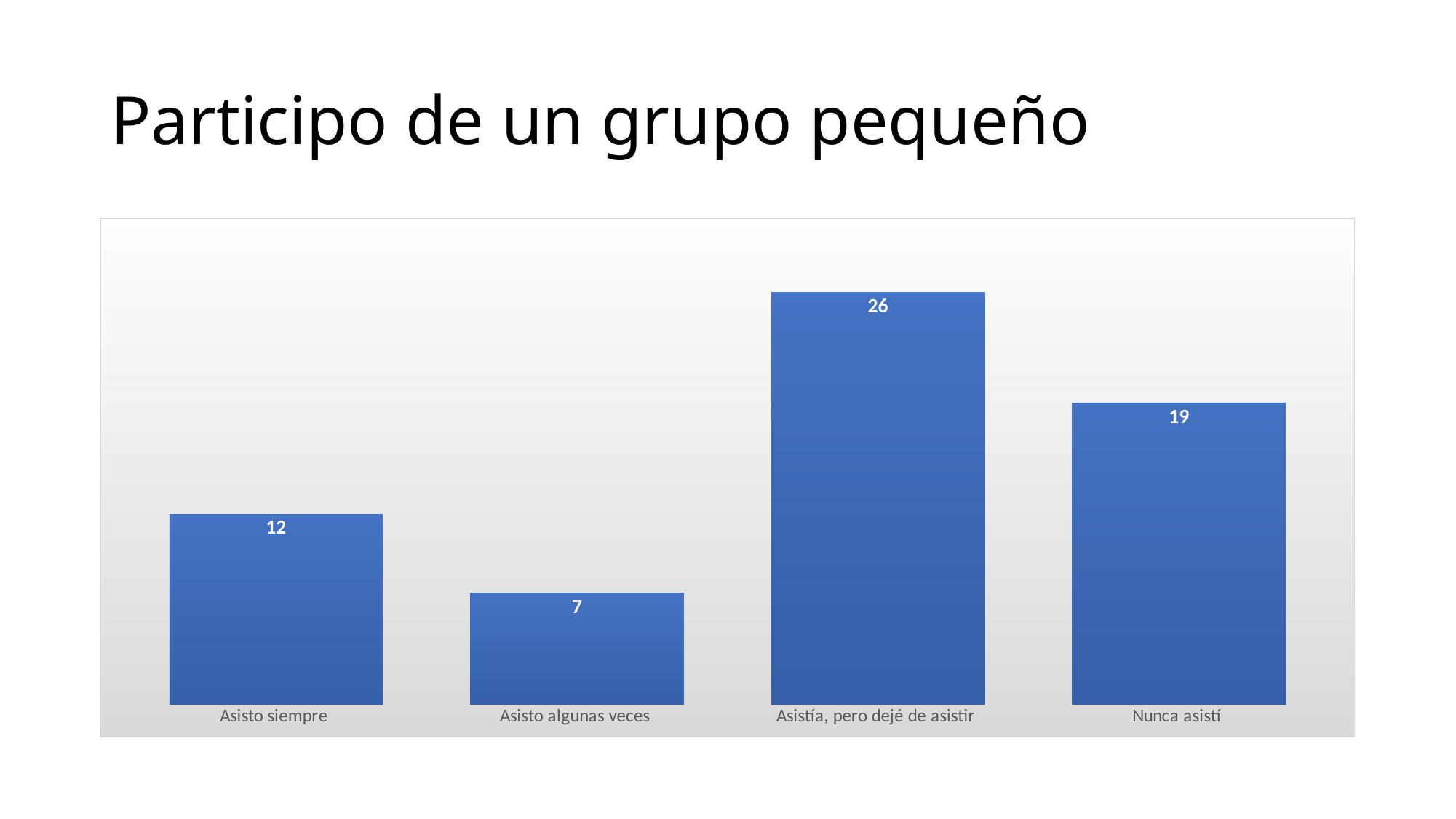
What is the value for "Asisto siempre"? 12 What is the value for "Asistía, pero dejé de asistir"? 26 Which category has the highest value? Asistía, pero dejé de asistir What is the value for "Asisto algunas veces"? 7 What is the difference between the values for "Asisto siempre" and "Asisto algunas veces"? 5 Which is larger, the value for "Nunca asistí" or the value for "Asisto siempre"? Nunca asistí How many categories are shown in the chart? 4 What is the difference between the values for "Asistía, pero dejé de asistir" and "Nunca asistí"? 7 What is the title of the slide? Participo de un grupo pequeño What kind of chart is shown on the slide? Bar chart Which category has the lowest value? Asisto algunas veces What is the value for "Nunca asistí"? 19